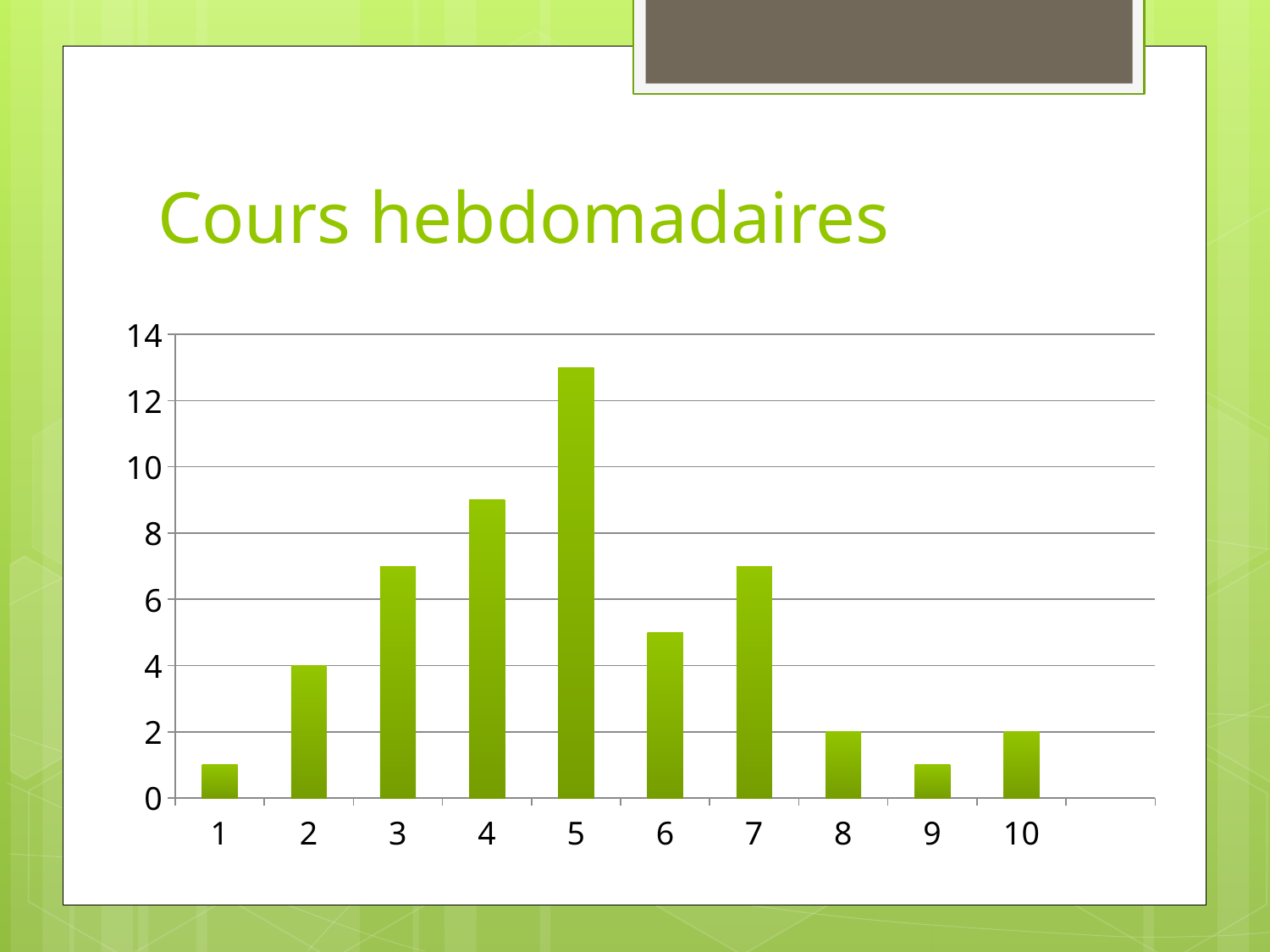
How many categories are shown on the x axis? 10 Which is larger, the value for category 4 or the value for category 6? category 4 What is the title of the chart? Cours hebdomadaires What is the difference between the values for category 2 and category 8? 2 Which category has the highest bar? 5 What type of chart is shown on the slide? bar chart What is the value for category 8? 2 Is the value for category 5 greater or less than 12? greater Is the value for category 9 greater or less than 2? less Is the value for category 4 greater or less than 8? greater What is the value for category 10? 2 What is the value for category 2? 4